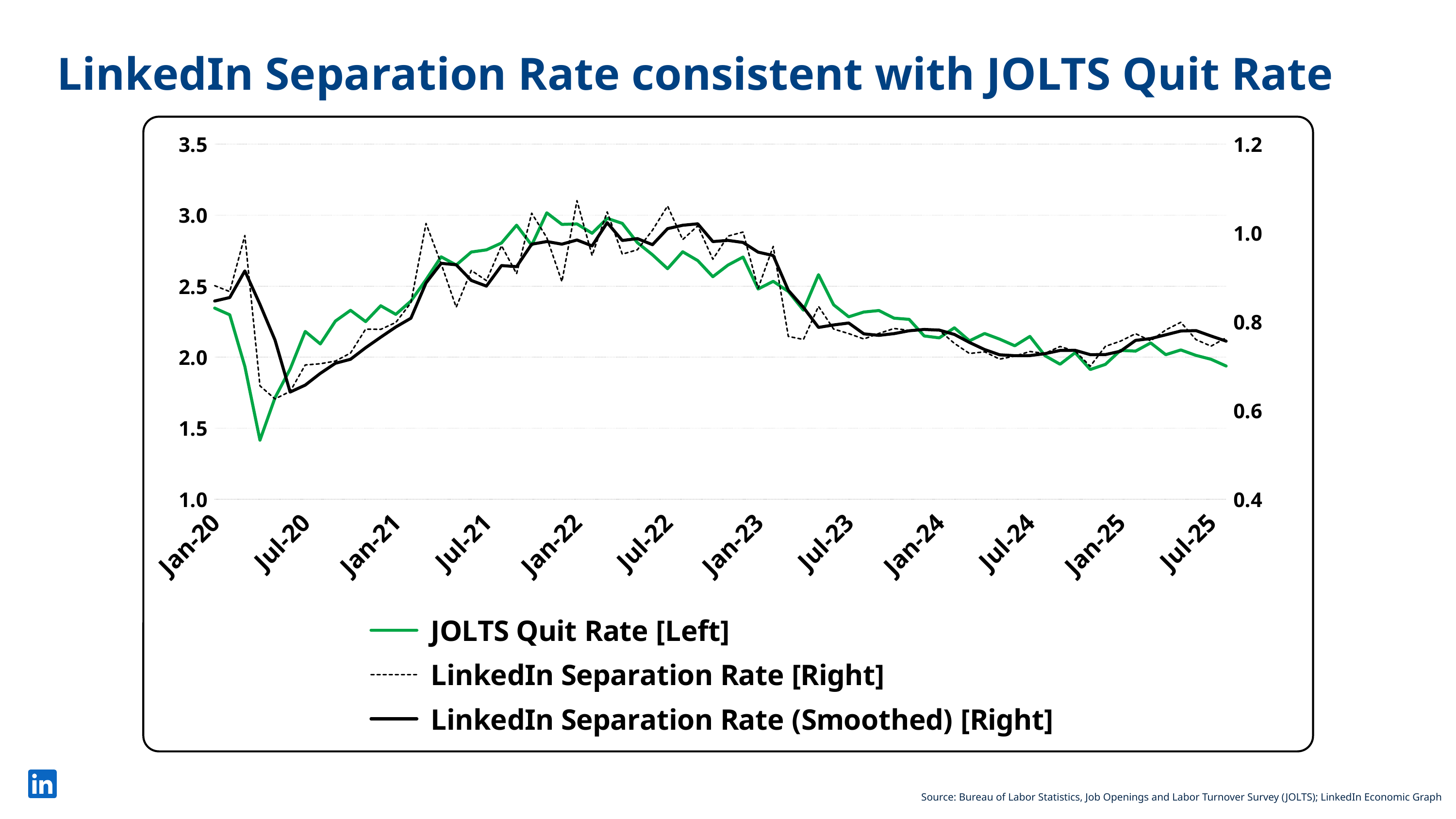
Is the LinkedIn Separation Rate (Smoothed) at Jan-22 greater or less than 0.8? greater Does the JOLTS Quit Rate rise or fall between Jan-22 and Jul-25? fall Is the JOLTS Quit Rate at Jan-20 greater or less than 2.0? greater What is the title of the slide's chart? LinkedIn Separation Rate consistent with JOLTS Quit Rate Is the JOLTS Quit Rate at Jul-25 greater or less than 2.5? less Which series is drawn in green? JOLTS Quit Rate [Left] How many date labels are shown on the x axis? 12 Is the JOLTS Quit Rate higher at Jan-22 or at Jul-25? Jan-22 What kind of chart is shown on the slide? line chart How many series does the legend list? 3